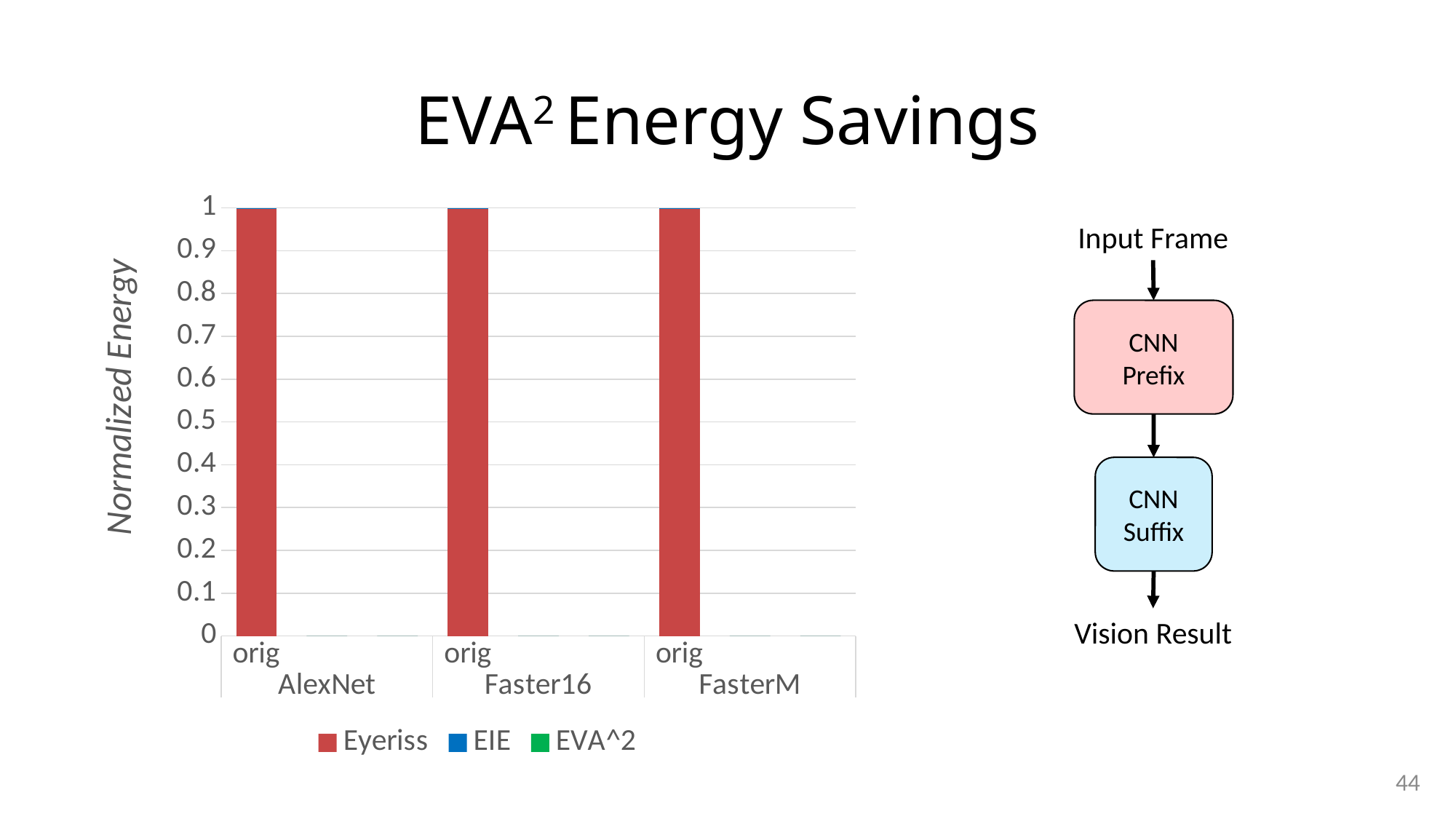
What is the total height of the stacked bar for AlexNet (orig)? 1 Which three networks are labelled on the x axis? AlexNet, Faster16, FasterM Is the Eyeriss value for AlexNet (orig) greater or less than 0.5? greater Which series makes up almost all of each stacked bar? Eyeriss How many bars are plotted in the chart? 3 Which colour represents the EIE series in the legend? blue What is the label of the vertical axis? Normalized Energy How many series does the chart legend list? 3 What kind of chart is shown on the slide? bar chart What is the total height of the stacked bar for Faster16 (orig)? 1 What is the total height of the stacked bar for FasterM (orig)? 1 Is the Eyeriss value for FasterM (orig) greater or less than 0.9? greater